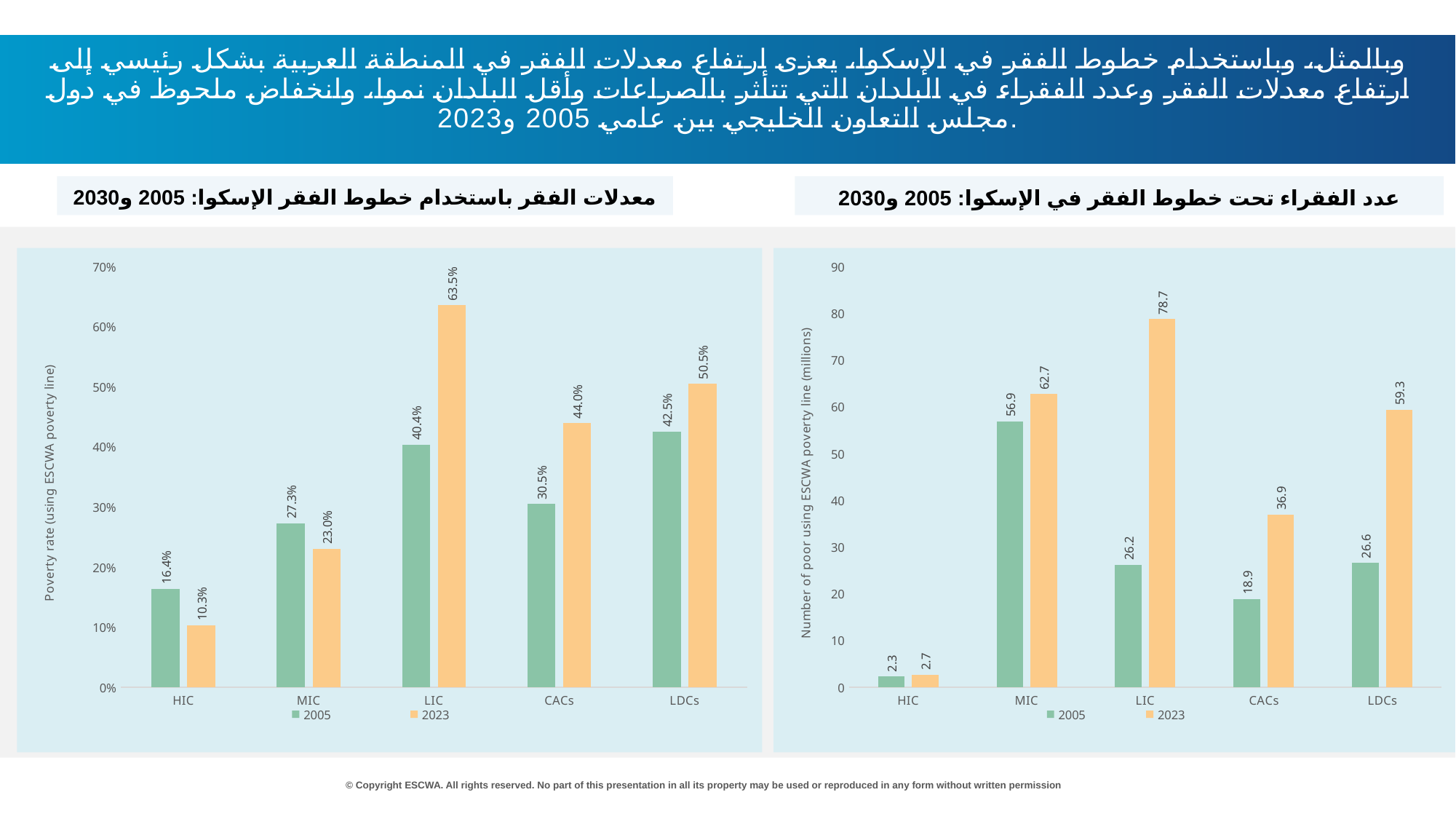
How many categories are shown on the x axis of the right chart (number of poor)? 5 What type of chart is the right chart (number of poor)? Bar chart In the left chart (poverty rate), what is the difference between the 2005 and 2023 values for MIC? 4.3% In the left chart (poverty rate), which category has the lowest 2023 value? HIC In the left chart (poverty rate), what is the 2005 value for HIC? 16.4% How many series does the legend of the left chart (poverty rate) list? 2 In the right chart (number of poor), which category has the highest 2023 value? LIC In the right chart (number of poor), what is the 2023 value for LDCs? 59.3 In the left chart (poverty rate), which is larger for CACs: the 2005 value or the 2023 value? 2023 In the right chart (number of poor), is the 2005 value for MIC greater or less than 50? greater In the right chart (number of poor), what is the difference between the 2023 and 2005 values for LIC? 52.5 In the left chart (poverty rate), what is the 2023 value for LIC? 63.5%